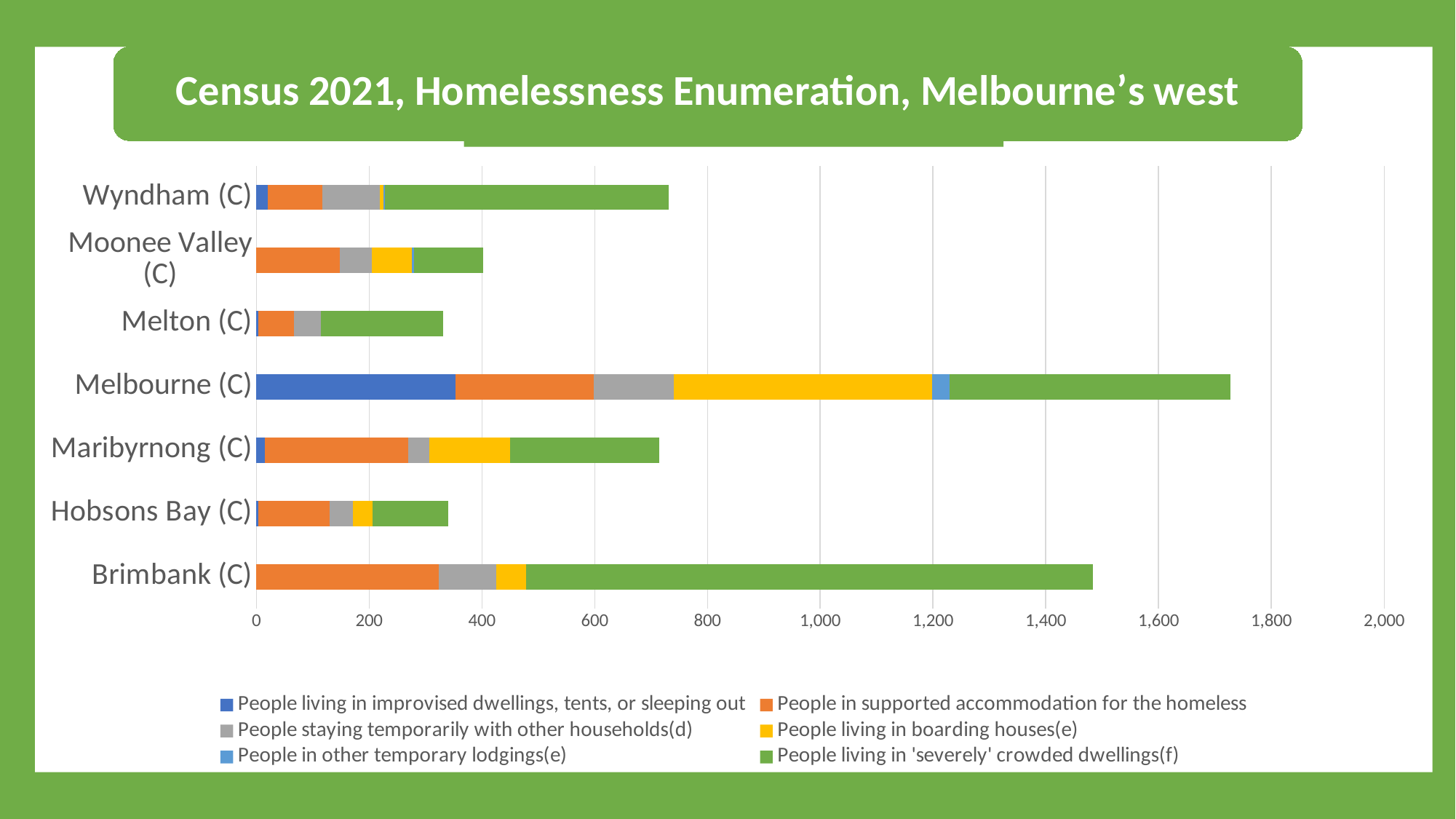
Is the total bar for Wyndham (C) greater or less than 800? less Is the total bar for Melton (C) greater or less than 400? less Which has the longer total bar, Melbourne (C) or Brimbank (C)? Melbourne (C) What kind of chart is shown on the slide? Stacked bar chart How many series does the legend list? 6 What is the title of the chart? Census 2021, Homelessness Enumeration, Melbourne's west Is the total bar for Brimbank (C) greater or less than 1,400? greater Which area has the highest total bar length? Melbourne (C) Which series is shown in green in the legend? People living in 'severely' crowded dwellings(f) Which has the longer total bar, Wyndham (C) or Moonee Valley (C)? Wyndham (C) How many local government areas (categories) are shown on the chart? 7